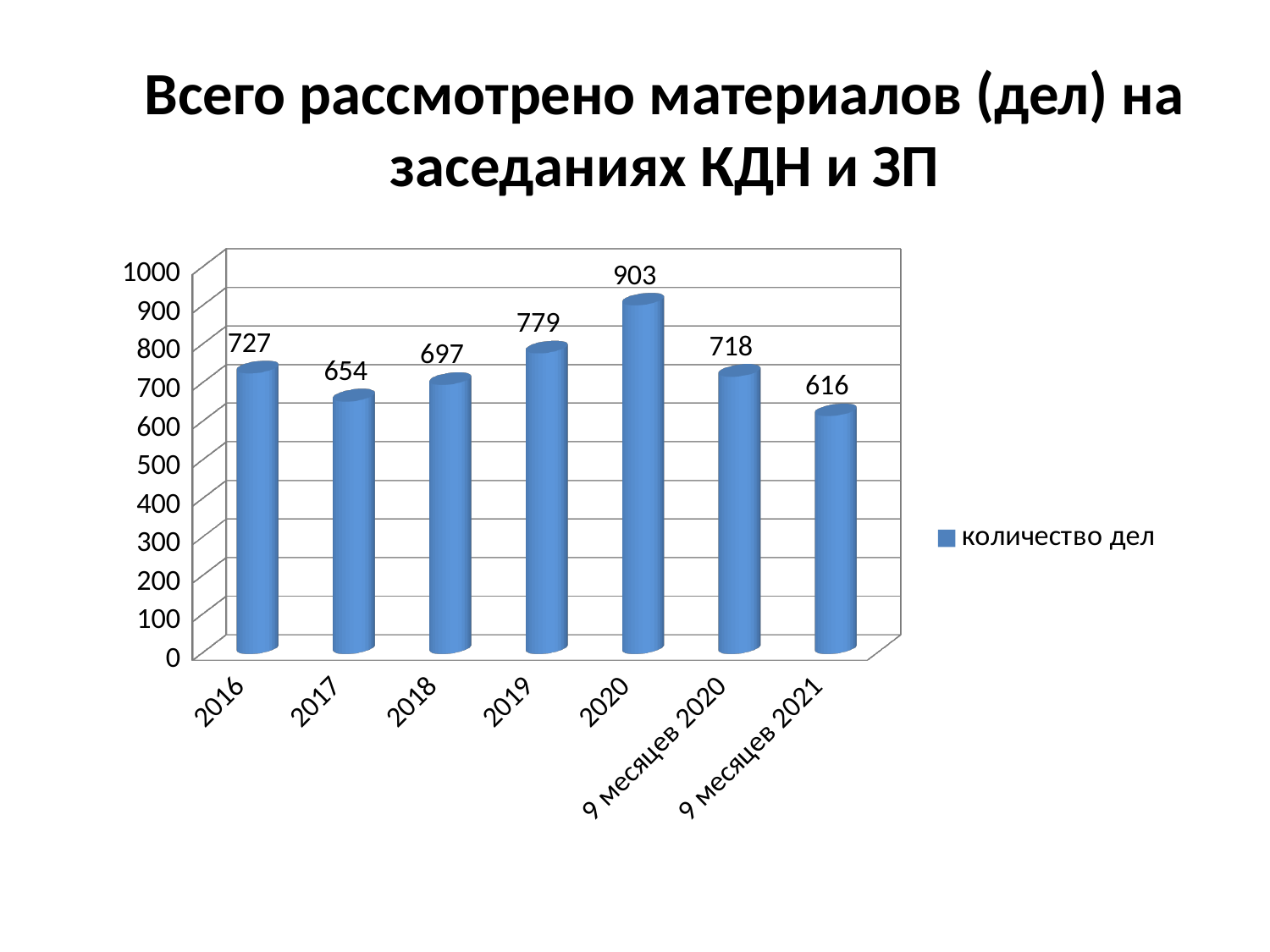
What is the difference between the values for 2020 and 2019? 124 Which category has the highest value? 2020 Which category has the lowest value? 9 месяцев 2021 What is the value for 2016? 727 Which is larger, the value for 2017 or the value for 2018? 2018 What is the value for 2020? 903 How many categories are shown on the x axis? 7 What is the legend entry for the series? количество дел How many series does the legend list? 1 Is the value for 2019 greater or less than 700? greater What kind of chart is shown? bar chart What is the value for 9 месяцев 2021? 616